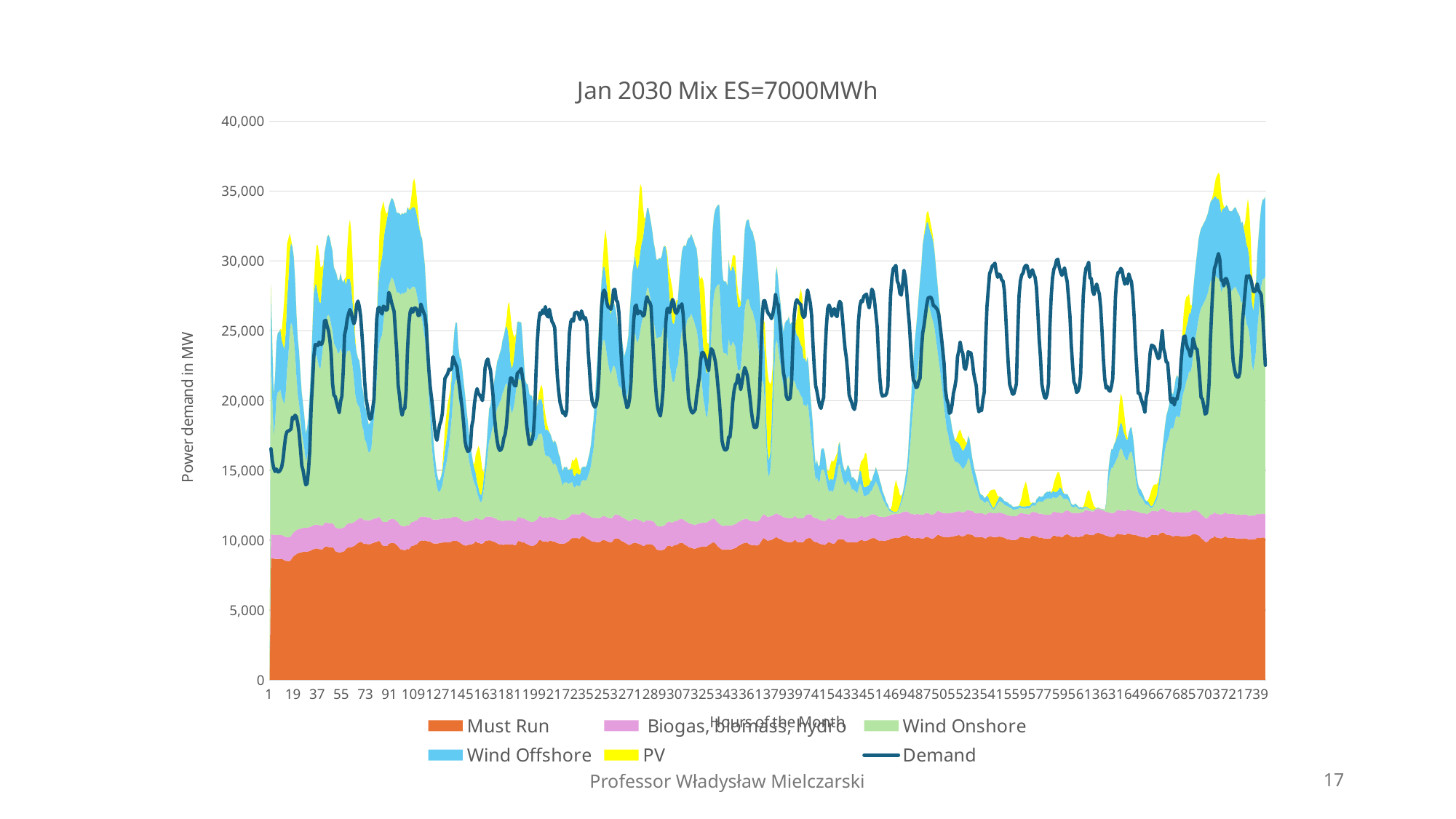
What is the title of the chart? Jan 2030 Mix ES=7000MWh Is the highest value of the Demand line greater or less than 35,000? less How many series does the legend list? 6 Is the top of the stacked area at hour 1 greater or less than 25,000? greater Which series is drawn as a line rather than a filled area? Demand Does the Must Run area ever exceed 15,000 during the month? No What kind of chart is shown on the slide? Stacked area chart with a line series Which series sits at the bottom of the stack? Must Run